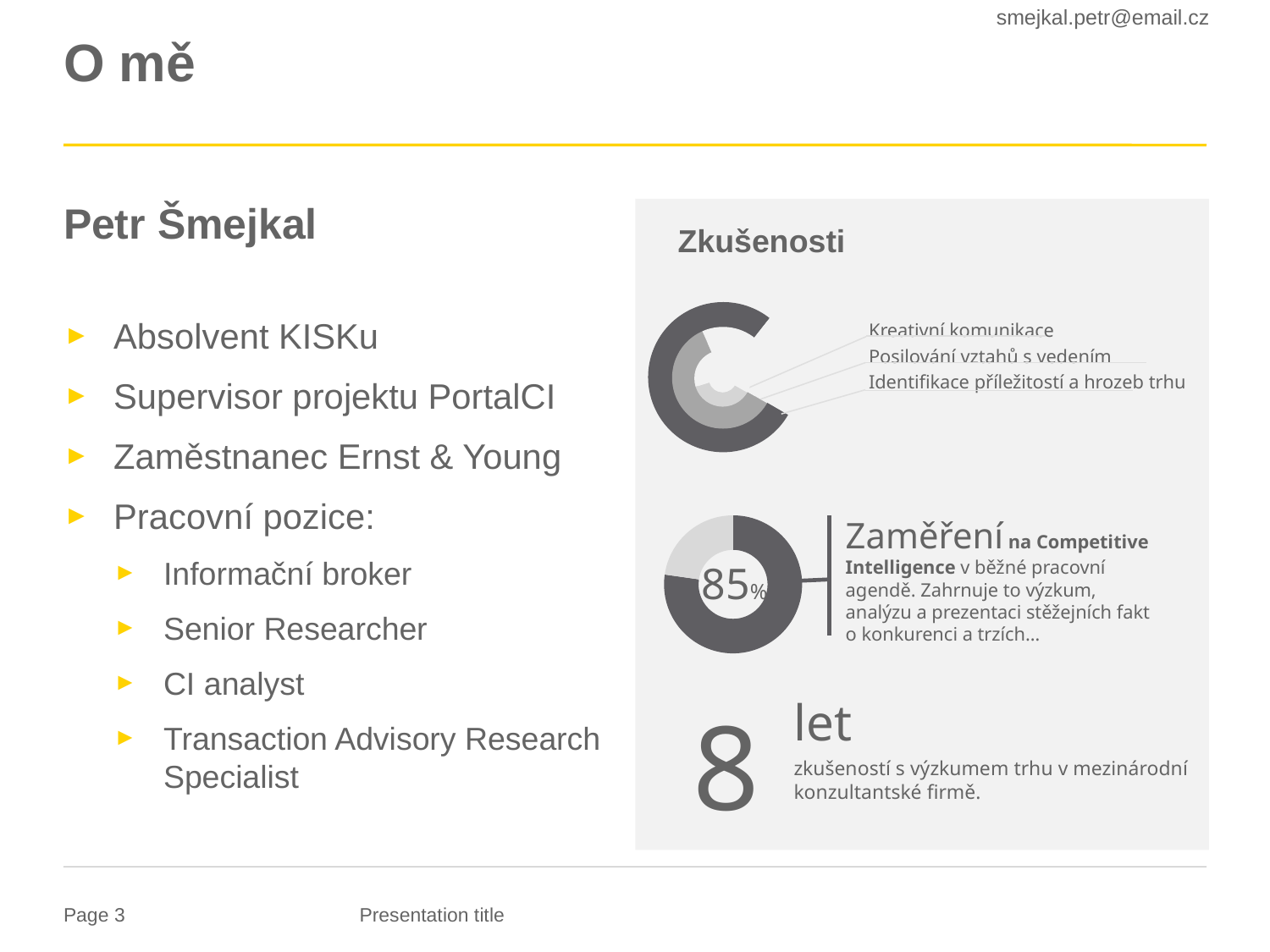
Which label in the concentric ring chart mentions identifying market opportunities and threats? Identifikace příležitostí a hrozeb trhu What percentage is shown in the centre of the donut chart next to the text 'Zaměření na Competitive Intelligence'? 85% What is the heading of the grey panel that contains the ring chart and the donut chart? Zkušenosti What kind of chart is the one displaying 85%? Donut (pie) chart What number is shown next to the word 'let' below the donut chart? 8 Is the value shown in the donut chart with the 'Zaměření' text greater or less than 50%? greater How many labelled rings does the concentric ring chart at the top of the 'Zkušenosti' panel have? 3